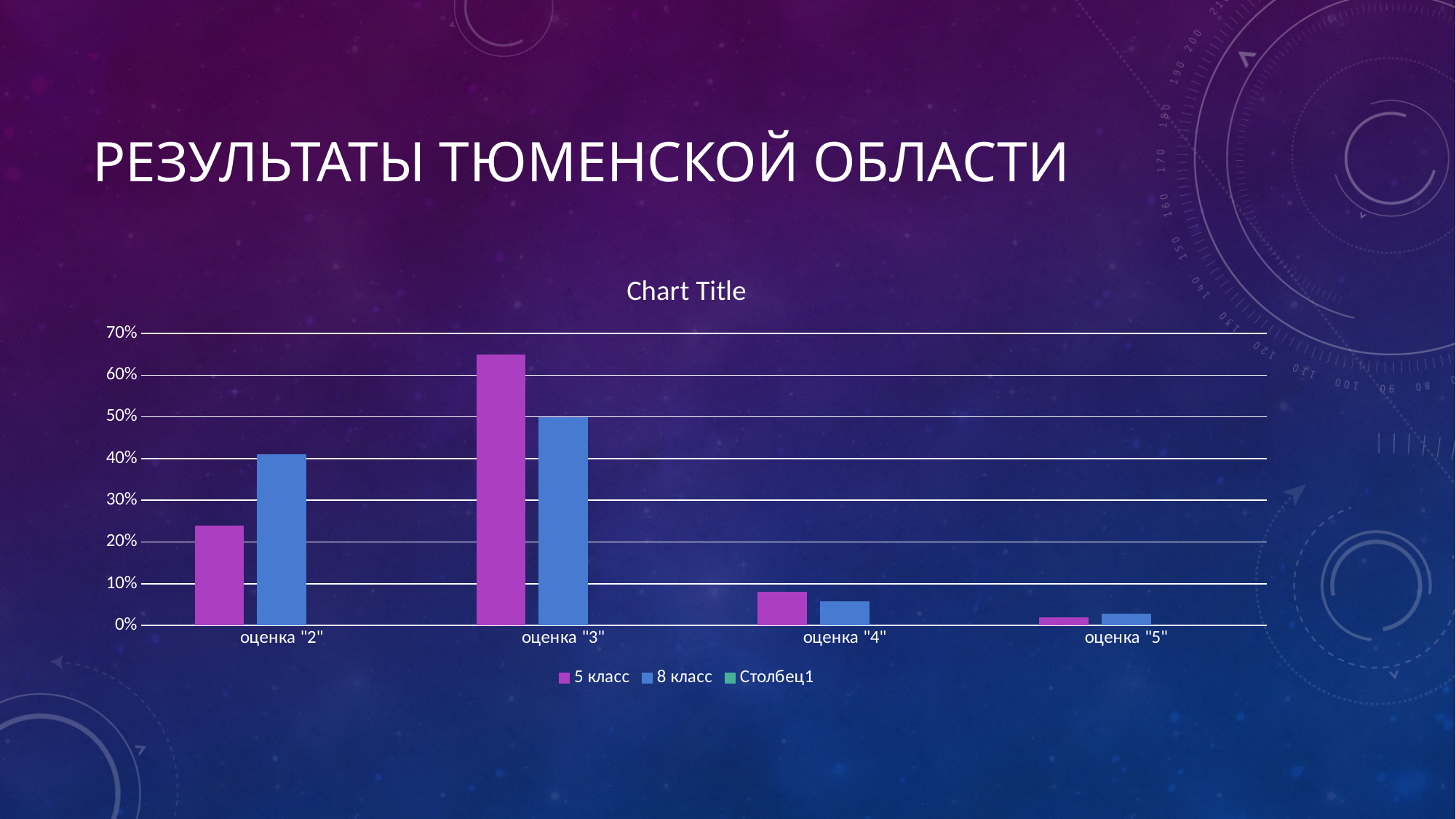
Which is larger at оценка "2": the value for 5 класс or for 8 класс? 8 класс How many categories are shown on the x axis of the chart? 4 Is the value for 5 класс at оценка "3" greater or less than 60%? greater Which category has the lowest value for the 8 класс series? оценка "5" What kind of chart is shown on the slide? bar chart What is the title shown above the chart? Chart Title How many series does the chart legend list? 3 Which category has the highest value for the 5 класс series? оценка "3" Which series is shown in purple in the chart legend? 5 класс Is the value for 5 класс at оценка "4" greater or less than 10%? less Which is larger at оценка "3": the value for 5 класс or for 8 класс? 5 класс